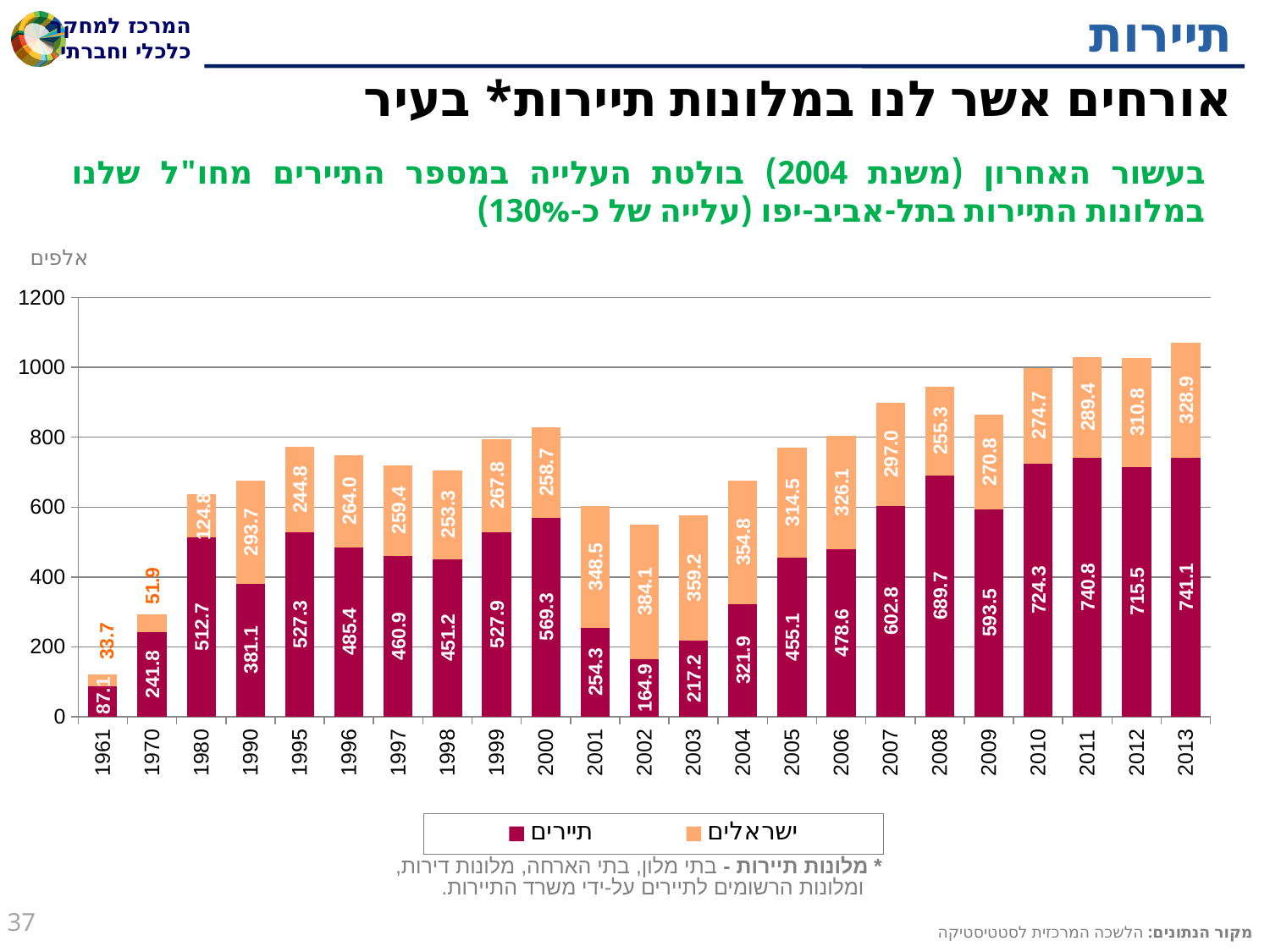
What is the value for ישראלים (Israelis) in 2002? 384.1 What is the value for תיירים (tourists) in 1961? 87.1 In which year is the value for ישראלים (Israelis) the highest? 2002 Which is larger in 2004: the value for תיירים (tourists) or the value for ישראלים (Israelis)? ישראלים (Israelis) Which colour represents the תיירים (tourists) series in the legend? dark red What is the total of the stacked bar for 2013? 1070.0 In which year is the value for תיירים (tourists) the lowest? 1961 How many years (categories) are shown on the x axis? 23 What is the value for תיירים (tourists) in 2013? 741.1 What type of chart is shown on the slide? stacked bar chart How many series does the legend list? 2 What is the difference between the ישראלים (Israelis) value and the תיירים (tourists) value in 2002? 219.2